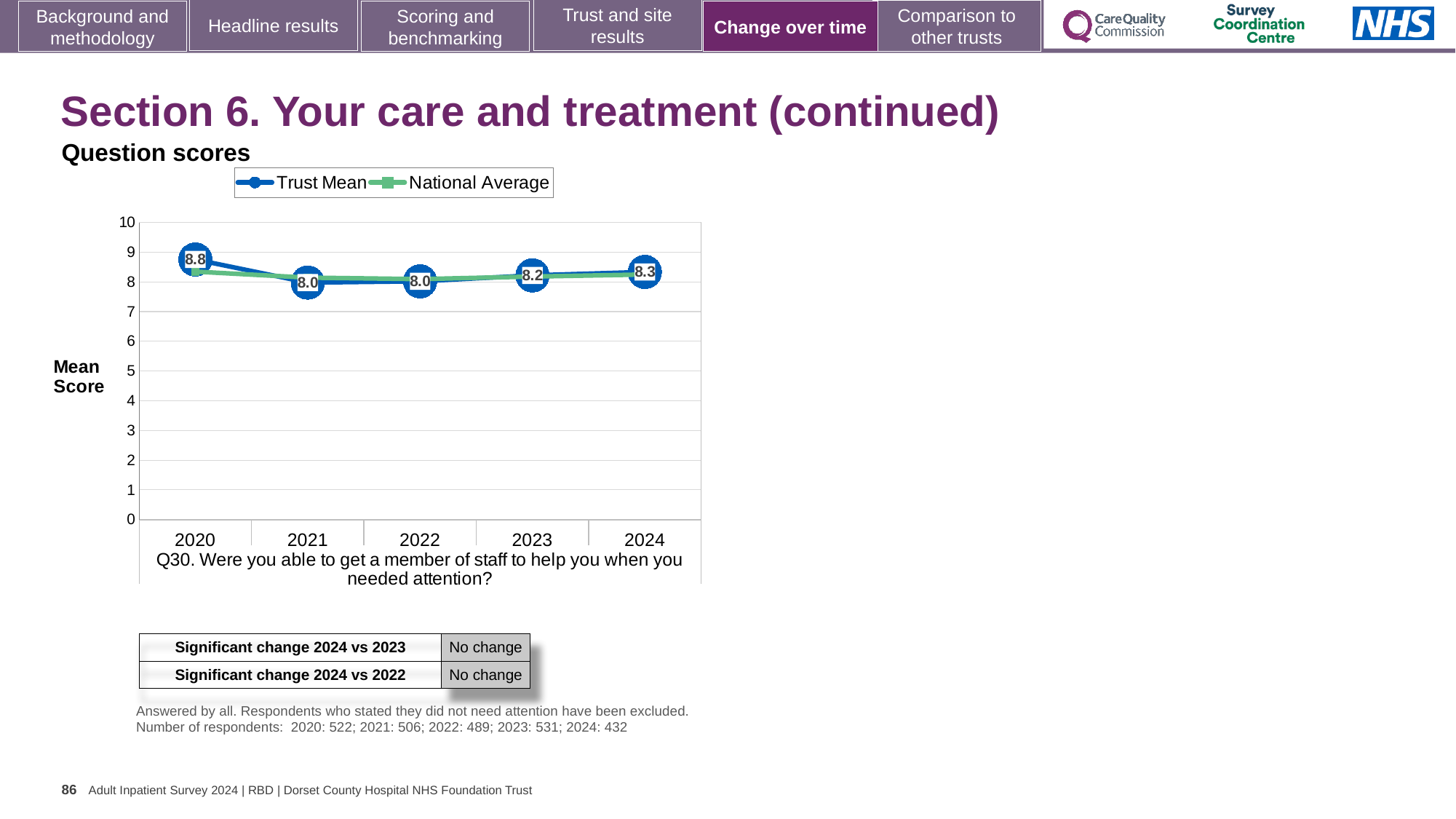
What kind of chart is shown on the slide? Line chart In which year is the Trust Mean score highest? 2020 What is the difference between the Trust Mean scores for 2020 and 2024? 0.5 Does the Trust Mean score rise or fall from 2021 to 2024? Rise How many years are shown on the x axis of the chart? 5 What is the Trust Mean score for 2023? 8.2 How many series does the chart legend list? 2 What is the Trust Mean score for 2024? 8.3 Which year has the larger Trust Mean score, 2020 or 2021? 2020 What is the Trust Mean score for 2020? 8.8 What is the label of the y axis of the chart? Mean Score Is the National Average value for 2020 greater or less than 8? greater